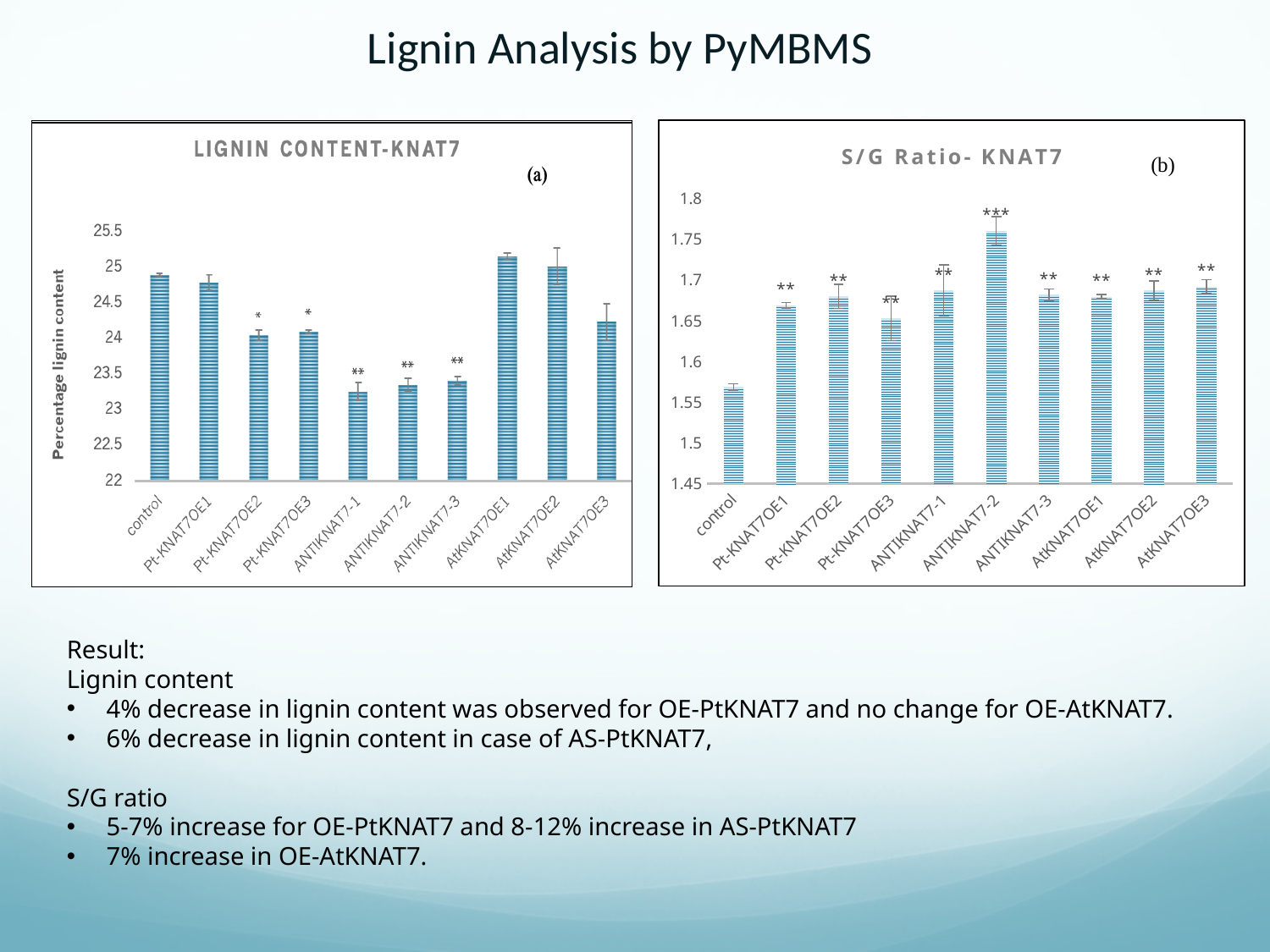
In the "LIGNIN CONTENT-KNAT7" chart, is the value for AtKNAT7OE1 greater or less than 25? greater In the "LIGNIN CONTENT-KNAT7" chart, is the value for ANTIKNAT7-1 greater or less than 23.5? less What is the y-axis title of the "LIGNIN CONTENT-KNAT7" chart? Percentage lignin content What kind of chart is the "LIGNIN CONTENT-KNAT7" chart on the left? bar chart In the "LIGNIN CONTENT-KNAT7" chart, which category has the highest bar? AtKNAT7OE1 How many categories are shown on the x axis of the "S/G Ratio- KNAT7" chart on the right? 10 In the "S/G Ratio- KNAT7" chart, which is larger, the value for control or the value for Pt-KNAT7OE1? Pt-KNAT7OE1 In the "S/G Ratio- KNAT7" chart, which category has the lowest bar? control In the "S/G Ratio- KNAT7" chart, is the value for control greater or less than 1.6? less In the "LIGNIN CONTENT-KNAT7" chart, which is larger, the value for control or the value for ANTIKNAT7-1? control In the "S/G Ratio- KNAT7" chart, which category has the highest bar? ANTIKNAT7-2